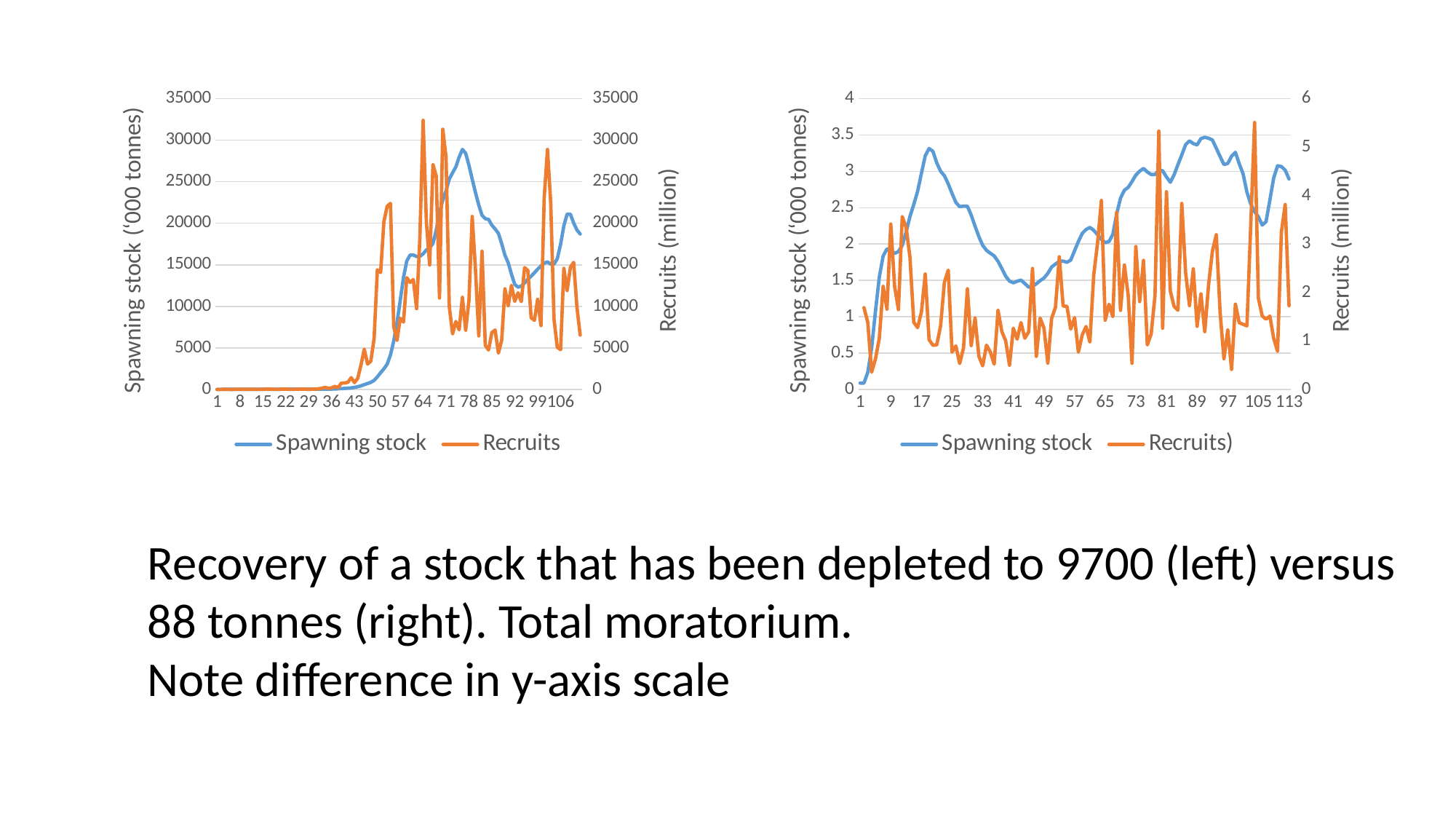
How many series does the legend of the right chart list? 2 In the right chart, is the Spawning stock value at x = 1 greater or less than 0.5? less What kind of chart is the right chart? line chart In the right chart, is the highest Spawning stock value greater or less than 3? greater What kind of chart is the left chart? line chart How many series does the legend of the left chart list? 2 In the right chart, what is the label of the right vertical axis? Recruits (million) In the right chart, does the Spawning stock series rise or fall between x = 17 and x = 41? fall In the left chart, what is the label of the left vertical axis? Spawning stock ('000 tonnes) In the left chart, is the highest Spawning stock value greater or less than 25000? greater In the left chart, does the Spawning stock series rise or fall between x = 43 and x = 78? rise